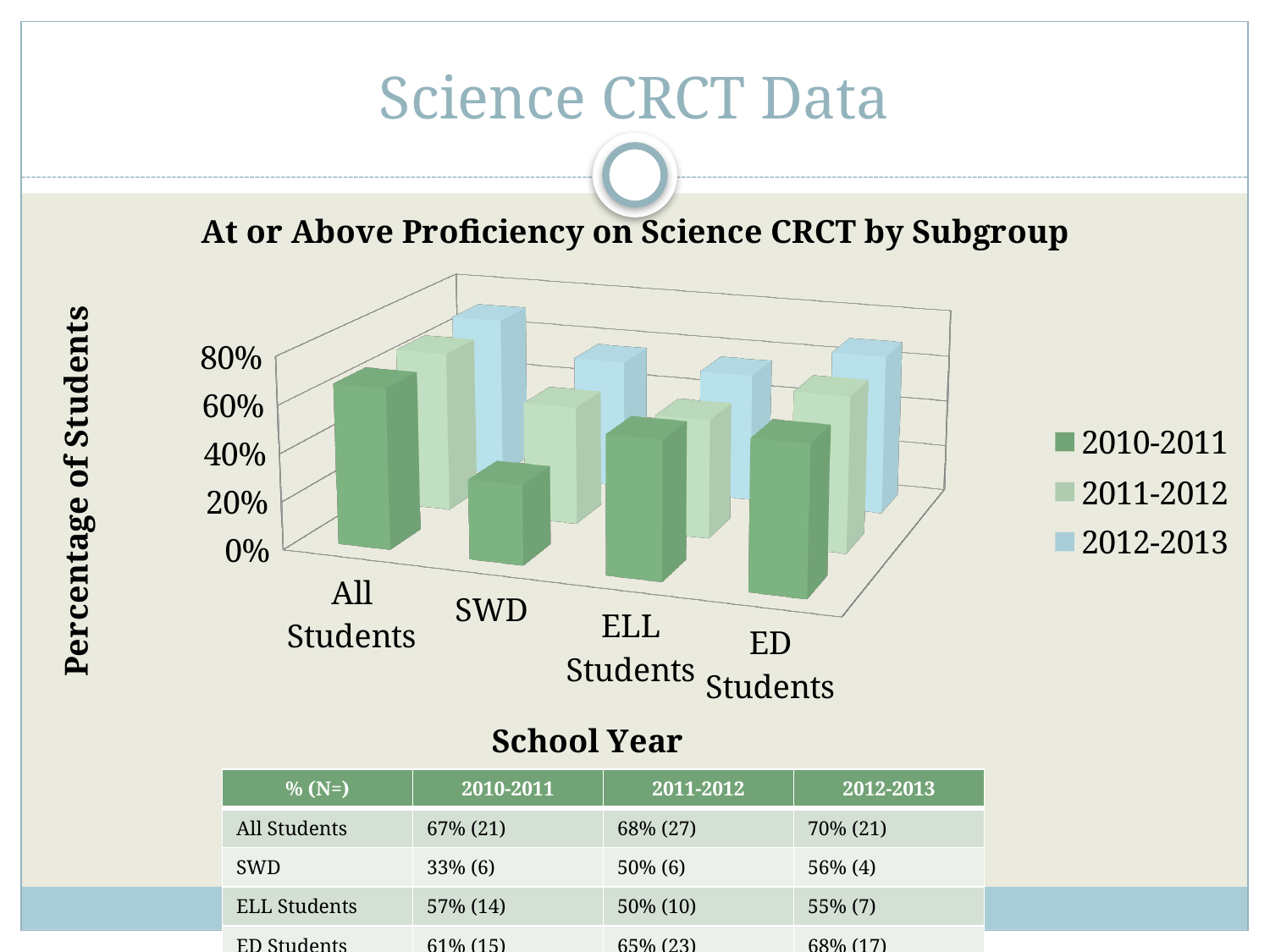
How many subgroup categories are shown on the x axis? 4 Which is larger: the ELL Students value for 2010-2011 or the ELL Students value for 2011-2012? 2010-2011 What is the difference between the SWD percentage in 2012-2013 and in 2010-2011? 23% What percentage of SWD were at or above proficiency in 2012-2013? 56% What type of chart is shown on the slide? bar chart What percentage of ELL Students were at or above proficiency in 2011-2012? 50% What percentage of All Students were at or above proficiency in 2010-2011? 67% What is the title of the chart? At or Above Proficiency on Science CRCT by Subgroup Which subgroup had the highest percentage at or above proficiency in 2012-2013? All Students How many series does the legend list? 3 Do the All Students values rise or fall from 2010-2011 to 2012-2013? rise Which subgroup had the lowest percentage at or above proficiency in 2010-2011? SWD